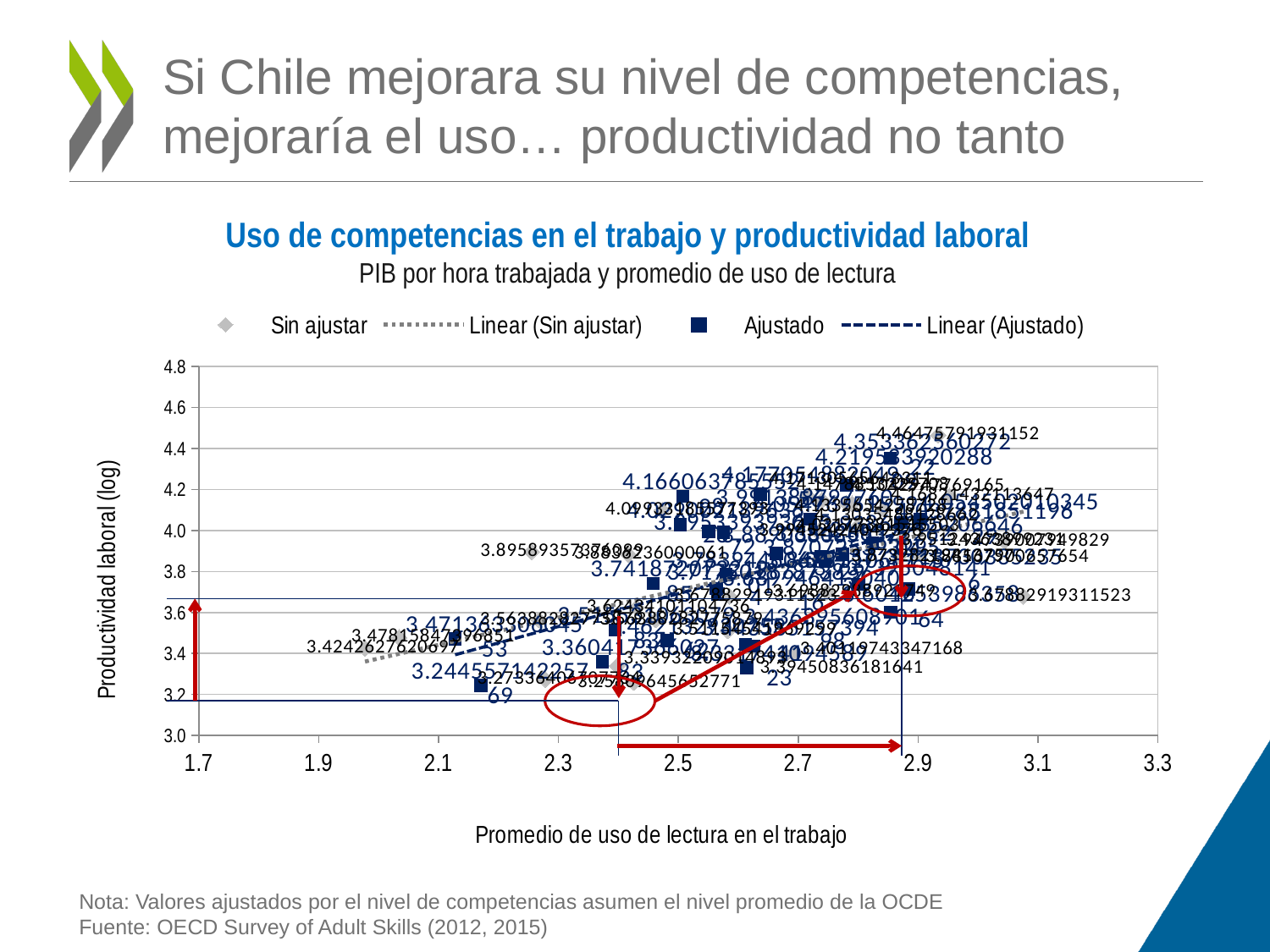
What kind of chart is shown on the slide? Scatter chart What is the highest value shown on the x axis? 3.3 What is the label of the x axis? Promedio de uso de lectura en el trabajo Do the plotted productivity values generally rise or fall as the average reading use increases along the x axis? Rise What is the title of the chart? Uso de competencias en el trabajo y productividad laboral What is the data label of the highest point on the chart? 4.46475791931152 What is the lowest value shown on the y axis? 3.0 How many entries does the chart legend list? 4 Which two data series (excluding trendlines) are shown in the legend? Sin ajustar and Ajustado Which is larger: the point labelled 4.46475791931152 or the point labelled 3.4242627620697? 4.46475791931152 Is the value of the leftmost Sin ajustar point (near x = 2.0) greater or less than 3.6? less Is the value of the highest point on the chart greater or less than 4.4? greater